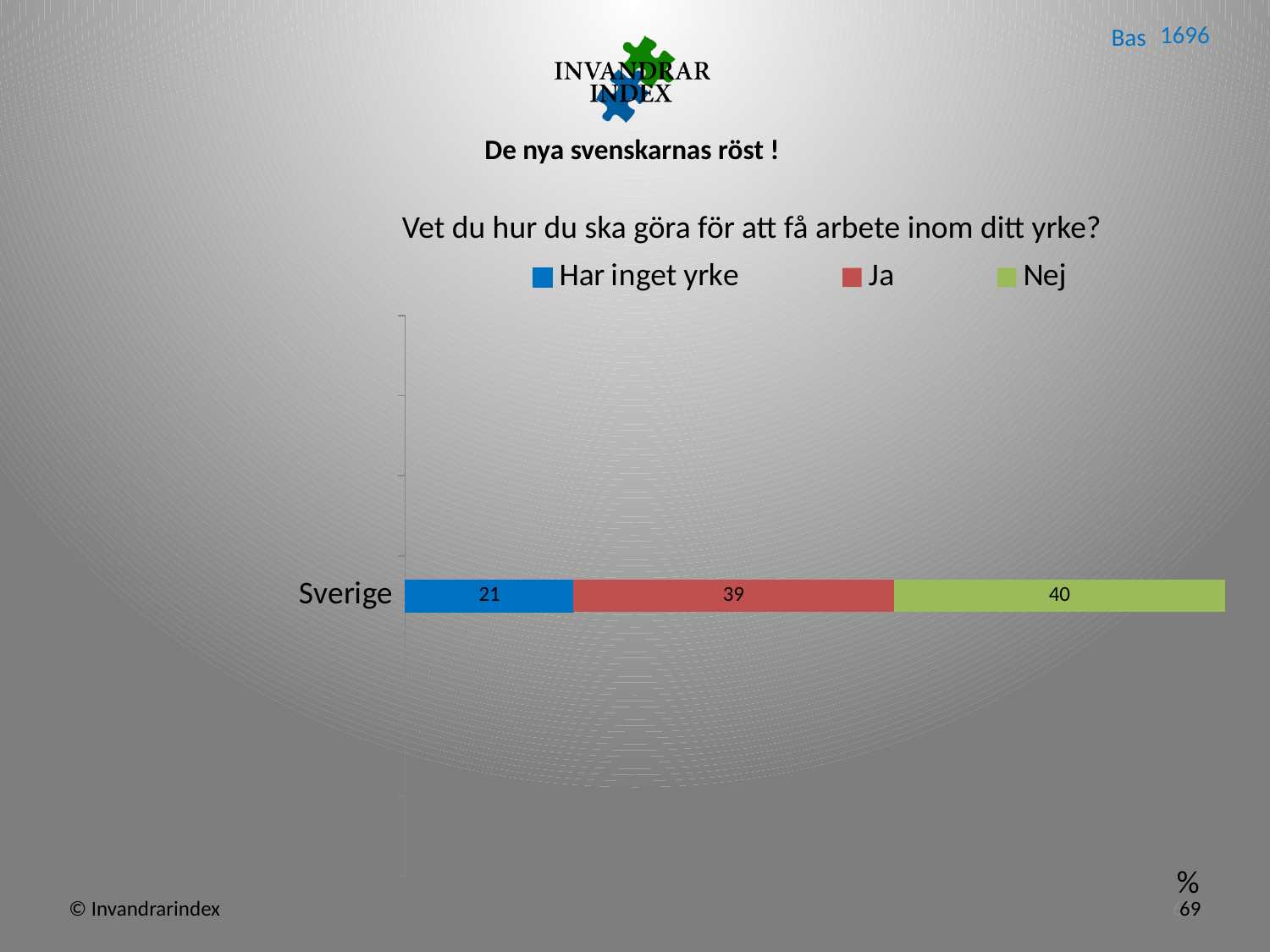
How many categories are shown on the chart? 1 What is the difference between the "Ja" and "Har inget yrke" values for Sverige? 18 What is the value for "Nej" for Sverige? 40 Which series has the lowest value for Sverige? Har inget yrke Which is larger for Sverige, "Ja" or "Har inget yrke"? Ja How many series does the legend list? 3 What is the value for "Har inget yrke" for Sverige? 21 Which series has the highest value for Sverige? Nej What is the title of the chart? Vet du hur du ska göra för att få arbete inom ditt yrke? What is the value for "Ja" for Sverige? 39 What is the total of the stacked bar for Sverige? 100 What kind of chart is shown on the slide? Stacked bar chart